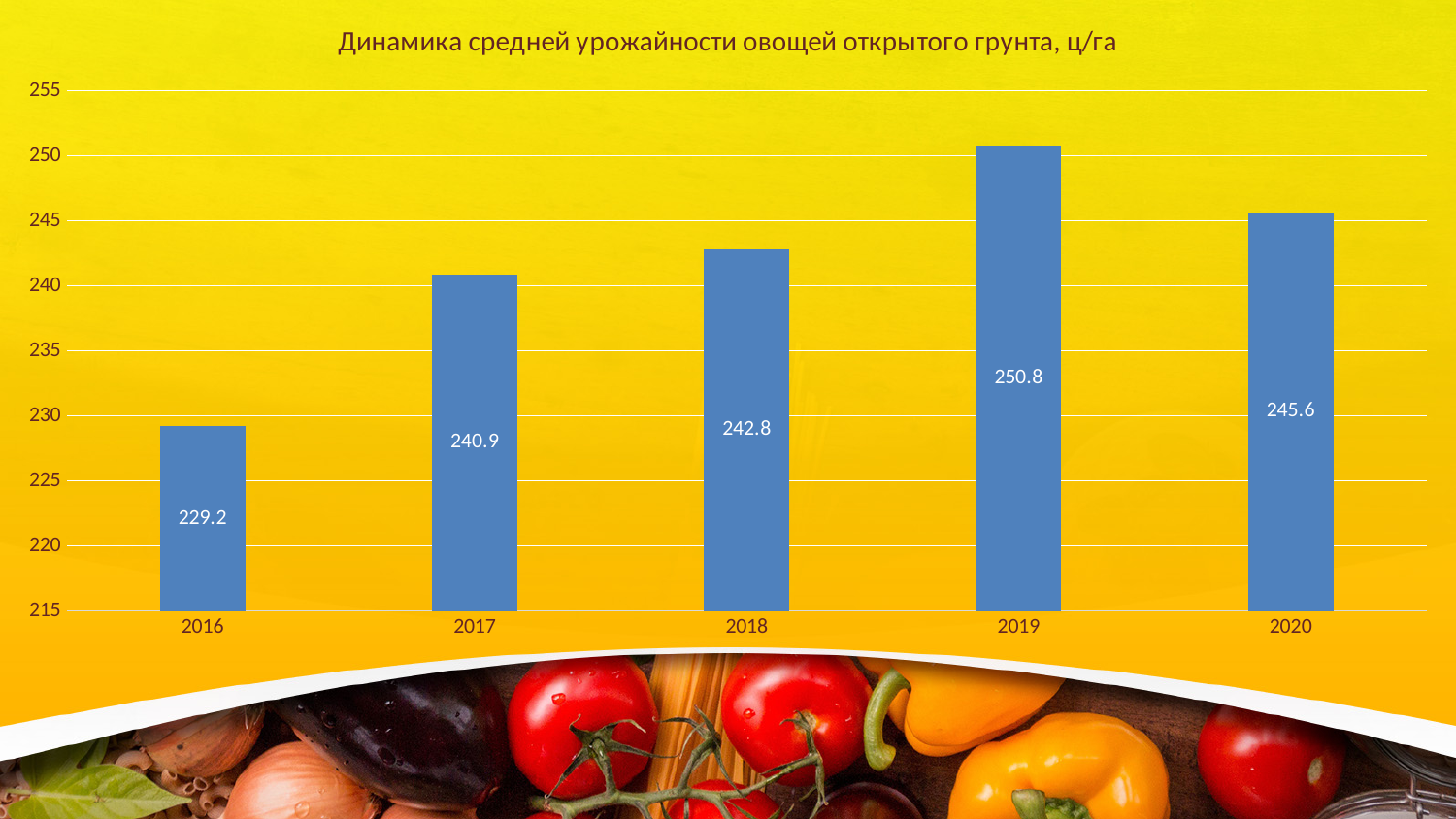
Which year has the highest value? 2019 What is the title of the chart? Динамика средней урожайности овощей открытого грунта, ц/га Which is larger, the value for 2020 or the value for 2018? 2020 What is the value shown for 2020? 245.6 Which year has the lowest value? 2016 Is the value for 2017 greater or less than 245? less What is the difference between the values for 2019 and 2016? 21.6 What kind of chart is shown on the slide? bar chart What is the average yield value shown for 2016? 229.2 How many years are shown on the x axis? 5 What is the value shown for 2019? 250.8 What is the difference between the values for 2018 and 2017? 1.9